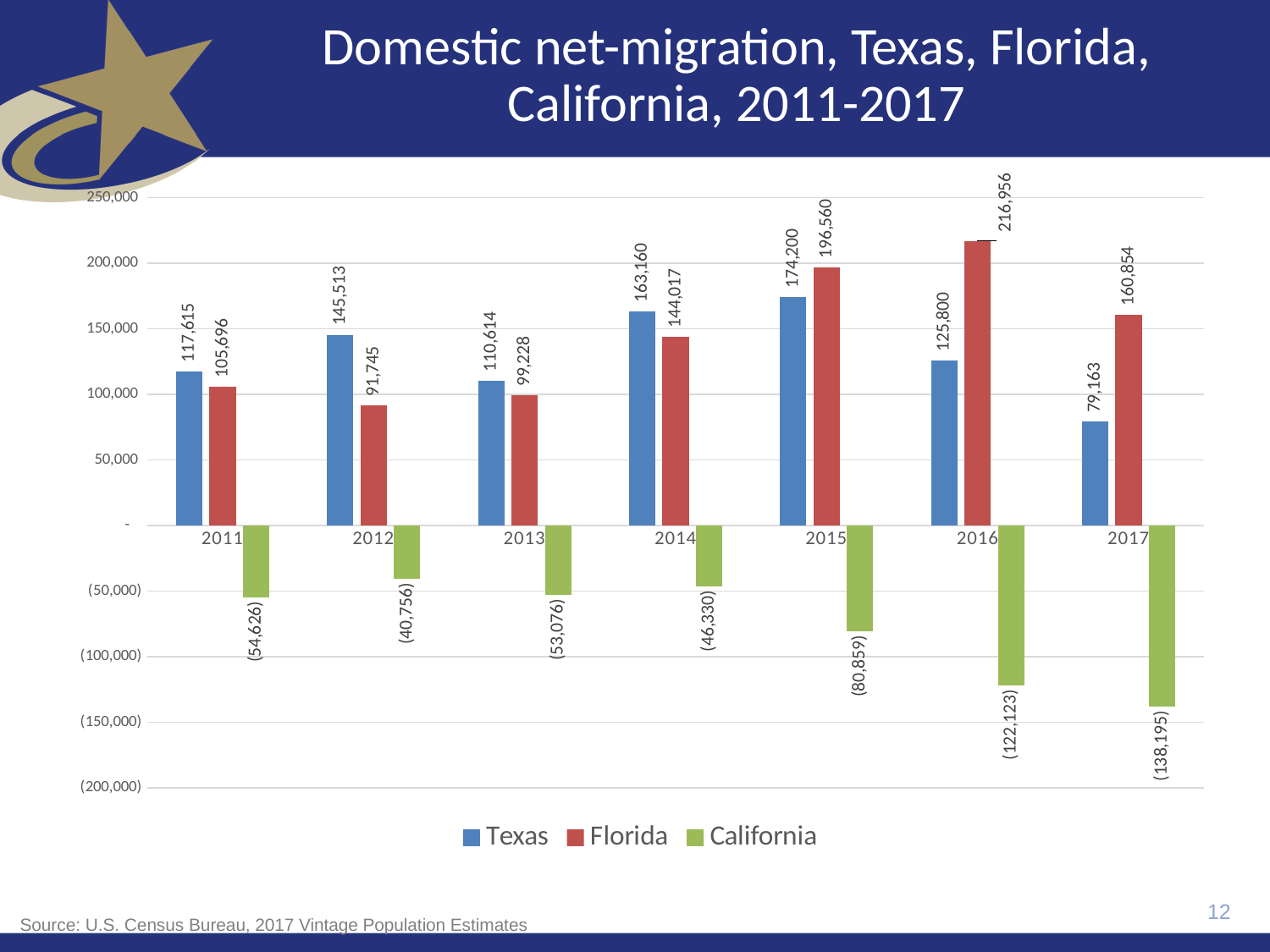
What kind of chart is shown on the slide? bar chart In which year is the Florida value highest? 2016 Is the value for Texas in 2016 greater or less than 150,000? less In 2015, which is larger, the Texas value or the Florida value? Florida What is the value for Florida in 2012? 91,745 What is the value for California in 2016? (122,123) What is the value for Texas in 2014? 163,160 What is the difference between the Texas and Florida values in 2011? 11,919 Does the Florida value rise or fall from 2014 to 2016? rise In which year is the Texas value lowest? 2017 How many years are shown on the x axis? 7 How many series does the legend list? 3